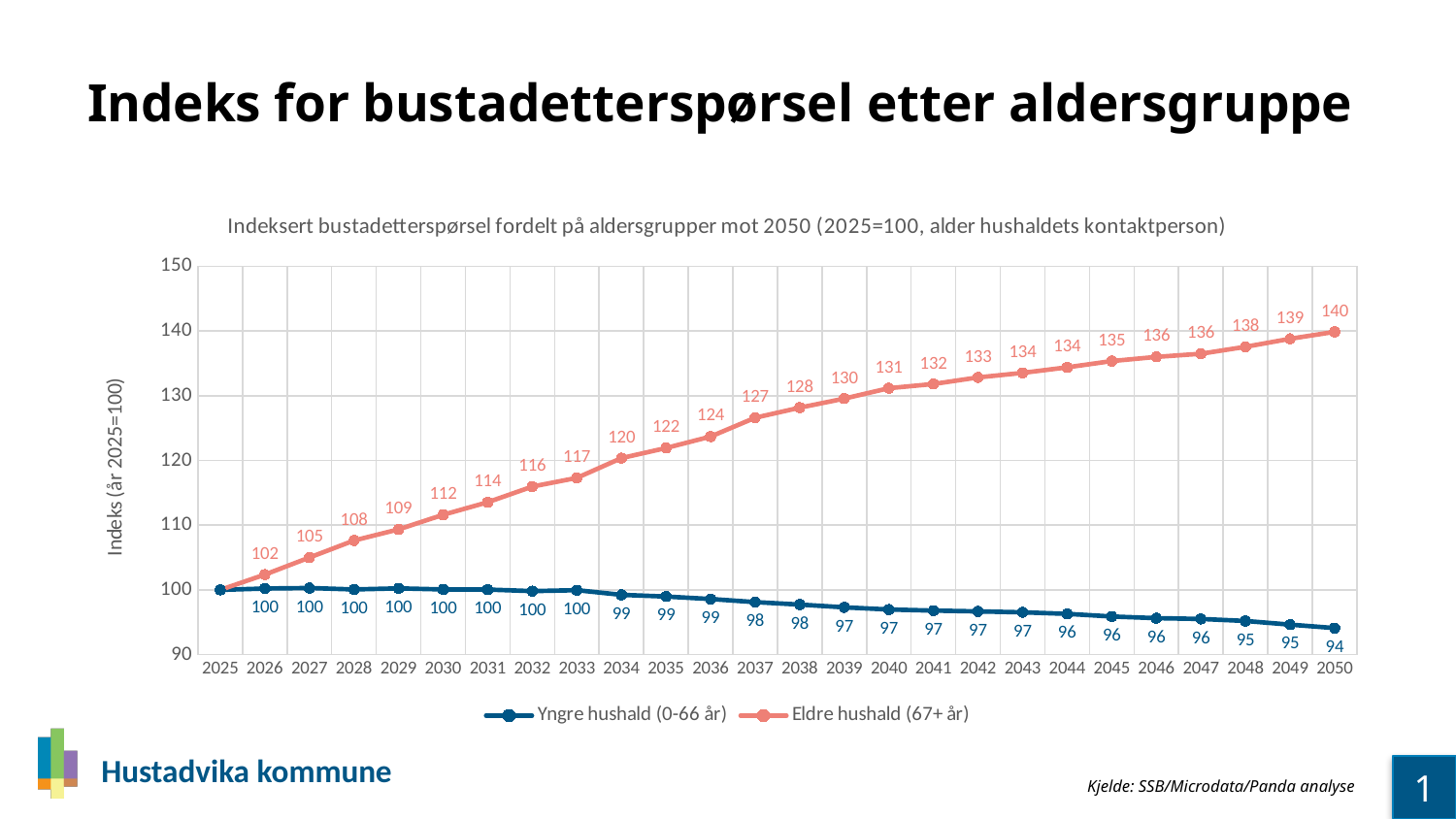
In which year does Yngre hushald (0-66 år) reach its lowest value? 2050 What is the value for Yngre hushald (0-66 år) in 2040? 97 Does the Eldre hushald (67+ år) series rise or fall from 2025 to 2050? Rise What type of chart is shown on the slide? Line chart Which series has the higher value in 2045, Yngre hushald (0-66 år) or Eldre hushald (67+ år)? Eldre hushald (67+ år) What is the difference between the Eldre hushald (67+ år) and Yngre hushald (0-66 år) values in 2050? 46 In which year does Eldre hushald (67+ år) reach its highest value? 2050 What is the label of the vertical axis? Indeks (år 2025=100) What is the value for Eldre hushald (67+ år) in 2037? 127 How many series does the legend list? 2 What is the value for Yngre hushald (0-66 år) in 2050? 94 What is the value for Eldre hushald (67+ år) in 2050? 140